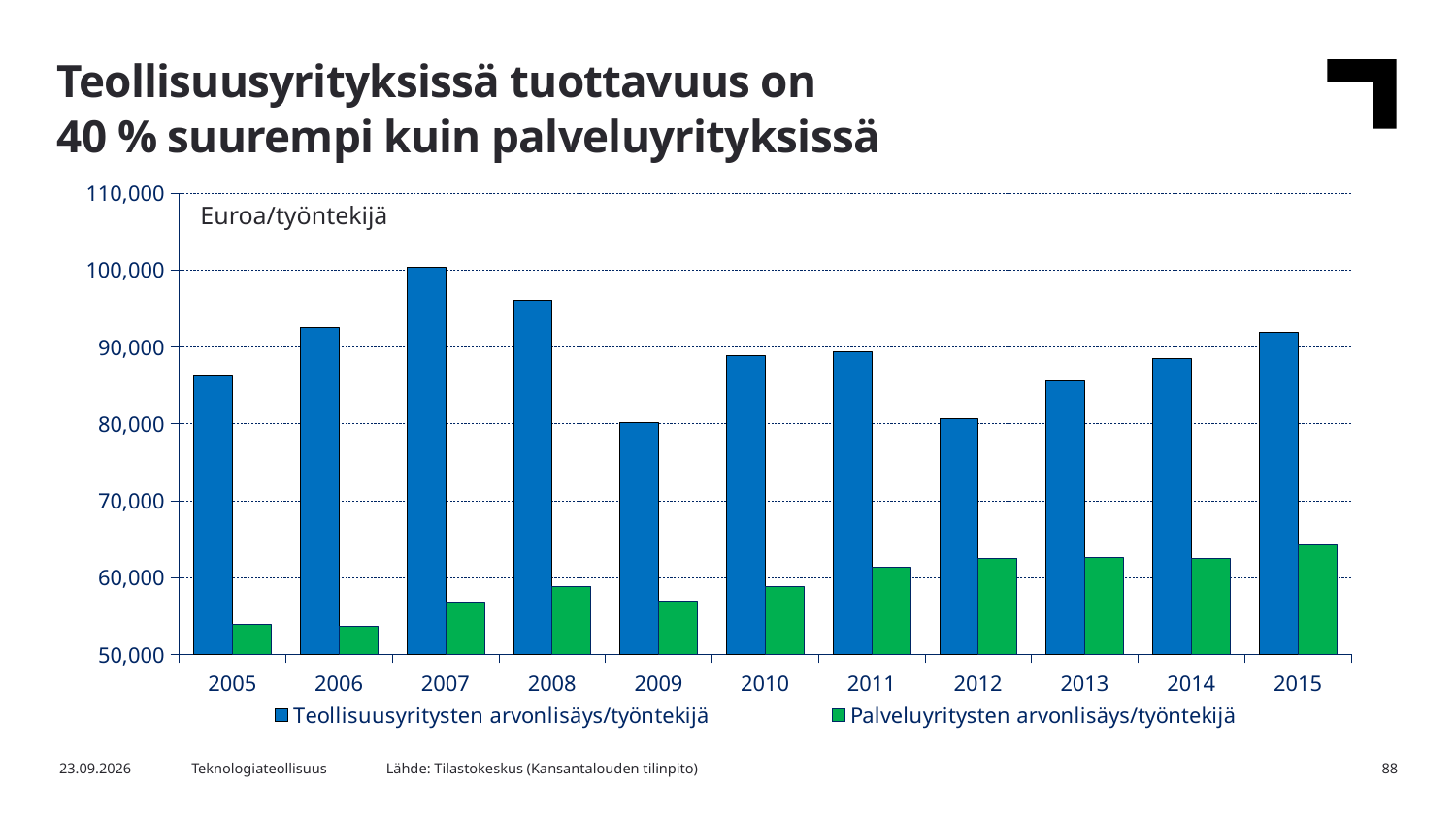
Is the value for Palveluyritysten arvonlisäys/työntekijä in 2005 greater or less than 60,000? less Is the value for Teollisuusyritysten arvonlisäys/työntekijä in 2009 greater or less than 90,000? less How many series does the legend list? 2 What unit label is shown inside the plot area at the top left? Euroa/työntekijä Which is larger for Palveluyritysten arvonlisäys/työntekijä: the value in 2005 or in 2015? 2015 Is the value for Teollisuusyritysten arvonlisäys/työntekijä in 2008 greater or less than 90,000? greater In which year is the value for Palveluyritysten arvonlisäys/työntekijä highest? 2015 How many years are shown on the x axis? 11 What kind of chart is shown on the slide? Bar chart Which is larger for Teollisuusyritysten arvonlisäys/työntekijä: the value in 2007 or in 2008? 2007 In which year is the value for Teollisuusyritysten arvonlisäys/työntekijä highest? 2007